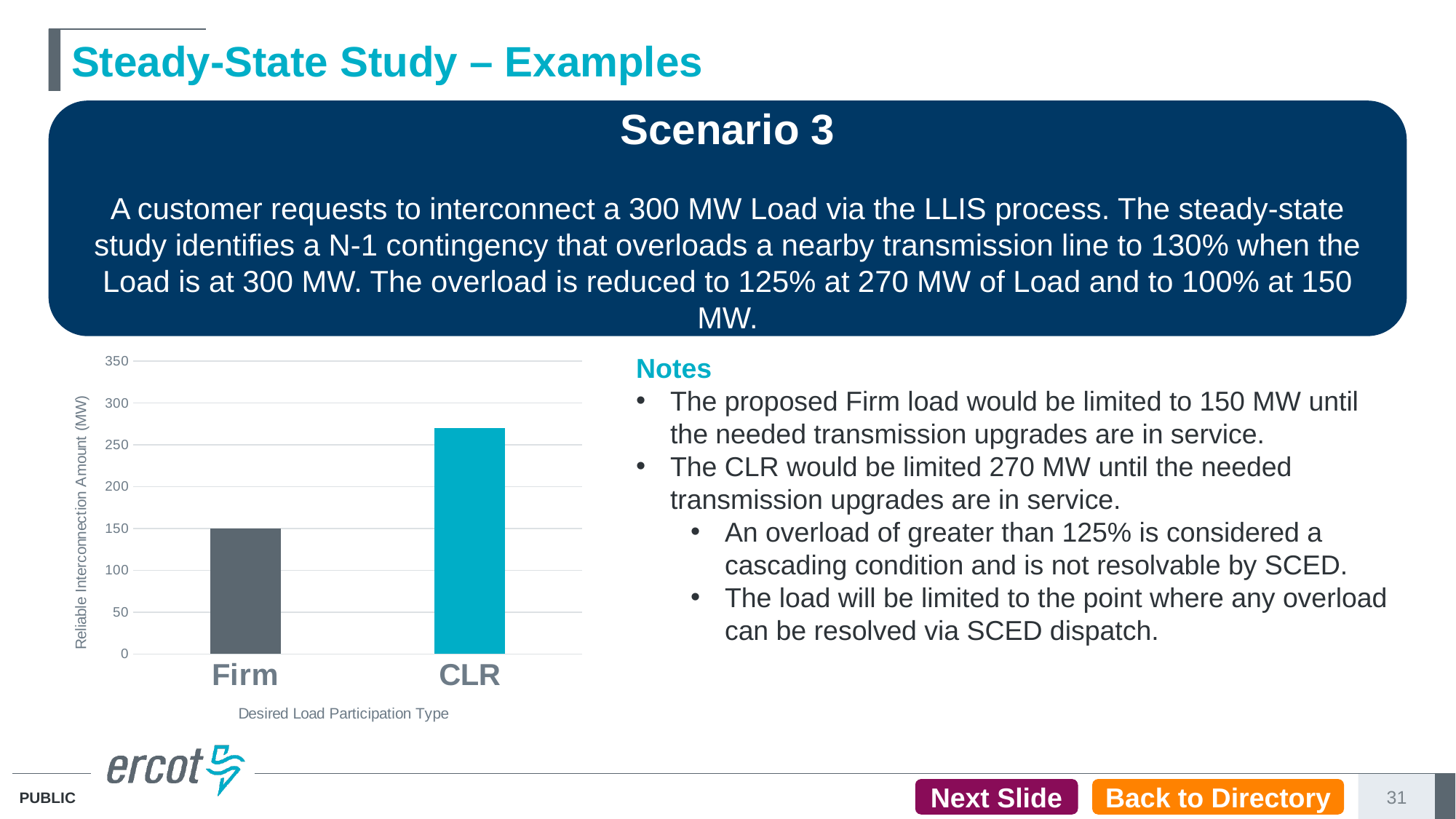
What is the title of the chart's x axis? Desired Load Participation Type Is the value for CLR greater or less than 250? greater Which has a larger Reliable Interconnection Amount, Firm or CLR? CLR What is the title of the chart's y axis? Reliable Interconnection Amount (MW) Is the value for Firm greater or less than 100? greater Is the value for Firm greater or less than 200? less What kind of chart is shown on the slide? bar chart Which category has the highest Reliable Interconnection Amount? CLR How many categories are plotted on the x axis of the chart? 2 Which category has the lowest Reliable Interconnection Amount? Firm What is the Reliable Interconnection Amount (MW) for Firm? 150